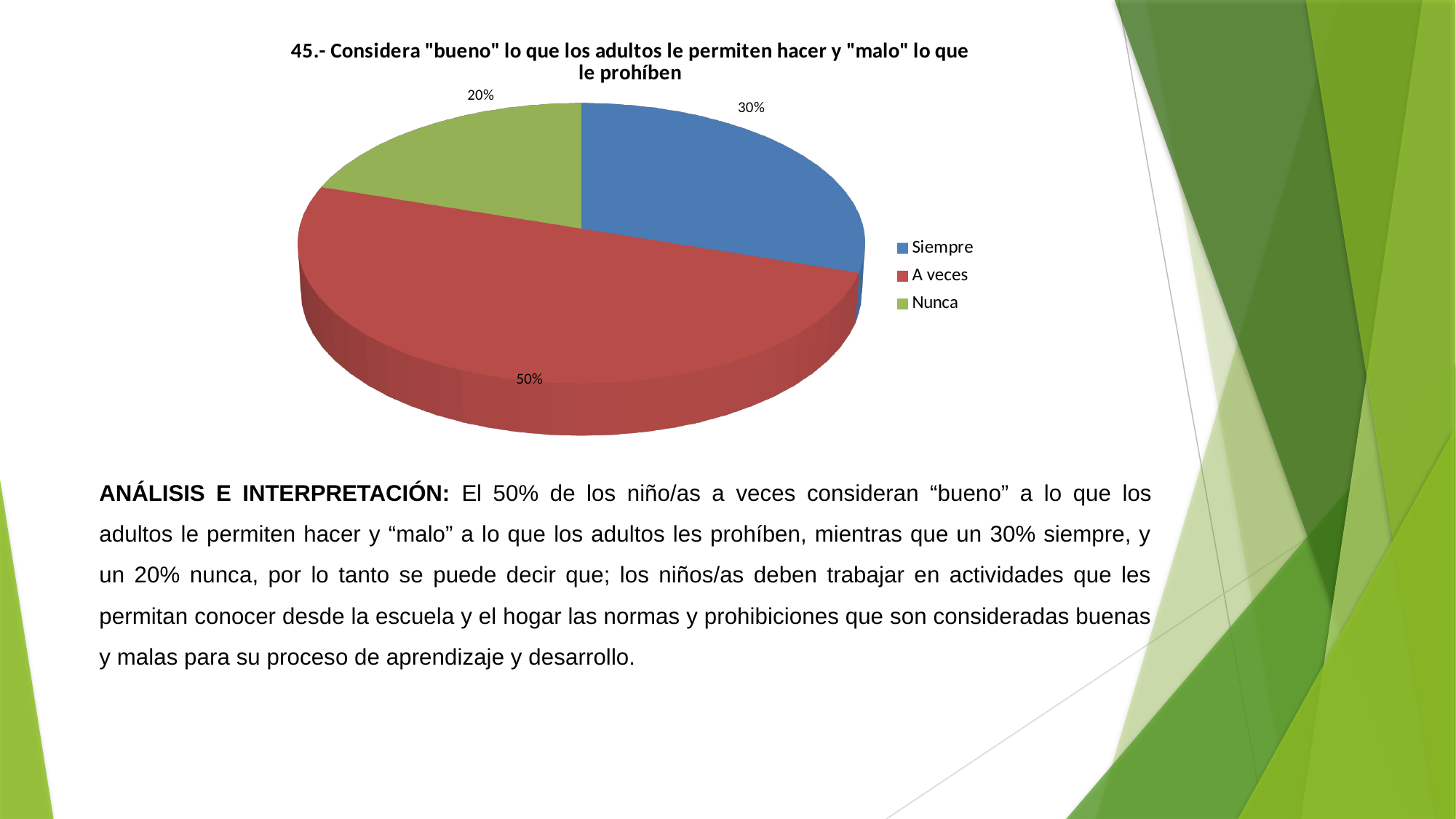
What kind of chart is shown on the slide? Pie chart What colour represents "A veces" in the pie chart? Red Which category has the smallest share of the pie chart? Nunca What is the number of the question in the chart title? 45 What is the difference in percentage points between "Siempre" and "Nunca"? 10 What percentage of the pie chart corresponds to "Siempre"? 30% Which is larger, the share for "Siempre" or the share for "Nunca"? Siempre What is the difference in percentage points between "A veces" and "Siempre"? 20 What percentage of the pie chart corresponds to "Nunca"? 20% How many categories does the pie chart show? 3 What percentage of the pie chart corresponds to "A veces"? 50% Which category has the largest share of the pie chart? A veces